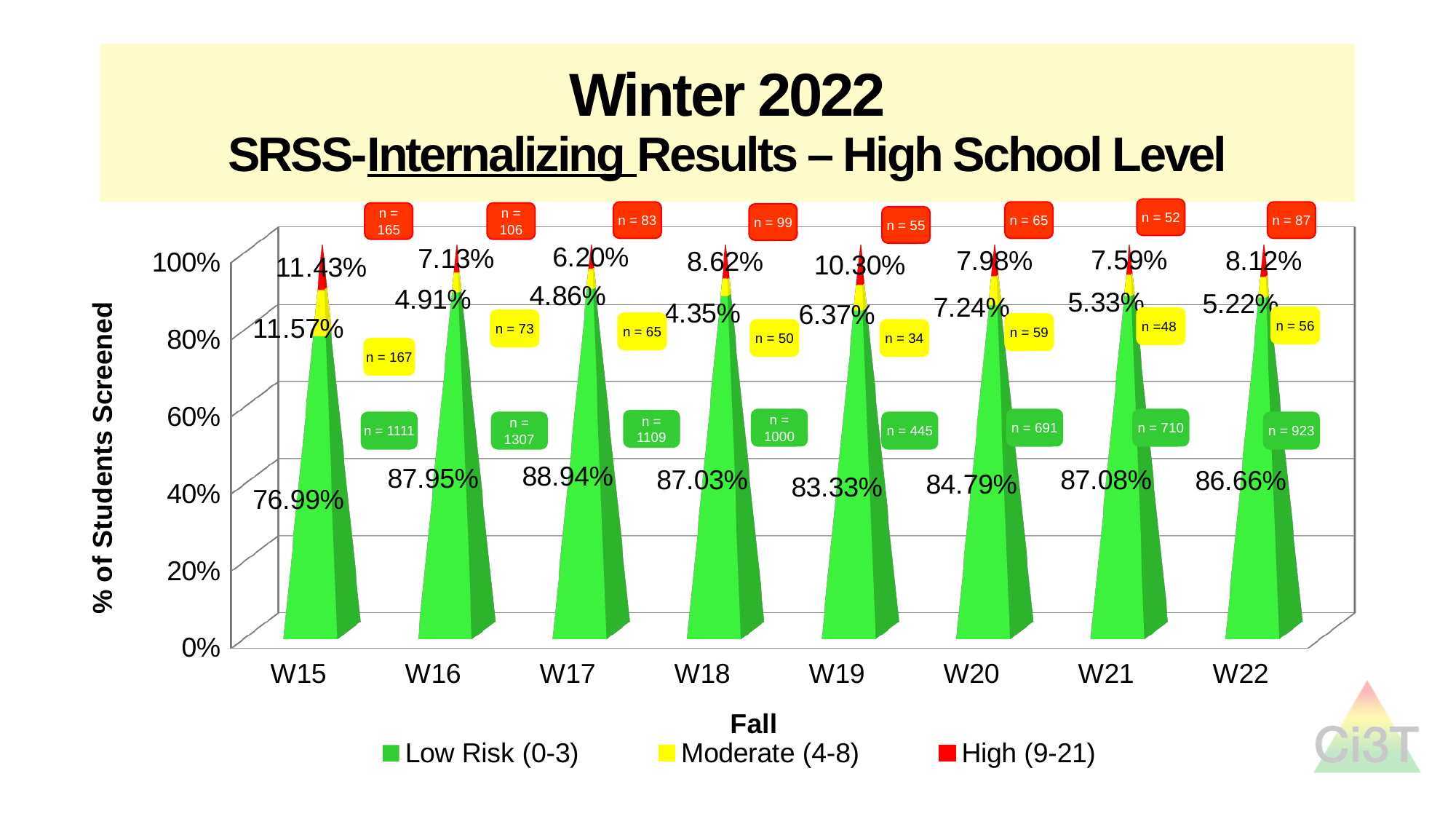
What is the Moderate (4-8) percentage for W15? 11.57% How many screening periods are shown on the x axis? 8 What is the High (9-21) percentage for W19? 10.30% What kind of chart is shown on the slide? Stacked bar chart What colour represents the High (9-21) series in the legend? Red Which screening period has the lowest Low Risk (0-3) percentage? W15 Which screening period has the highest Low Risk (0-3) percentage? W17 What is the Low Risk (0-3) percentage for W17? 88.94% How many series does the legend list? 3 Which screening period has the highest High (9-21) percentage? W15 Which has the larger Moderate (4-8) percentage, W20 or W21? W20 By how many percentage points does the Low Risk (0-3) value for W16 exceed that for W15? 10.96 percentage points